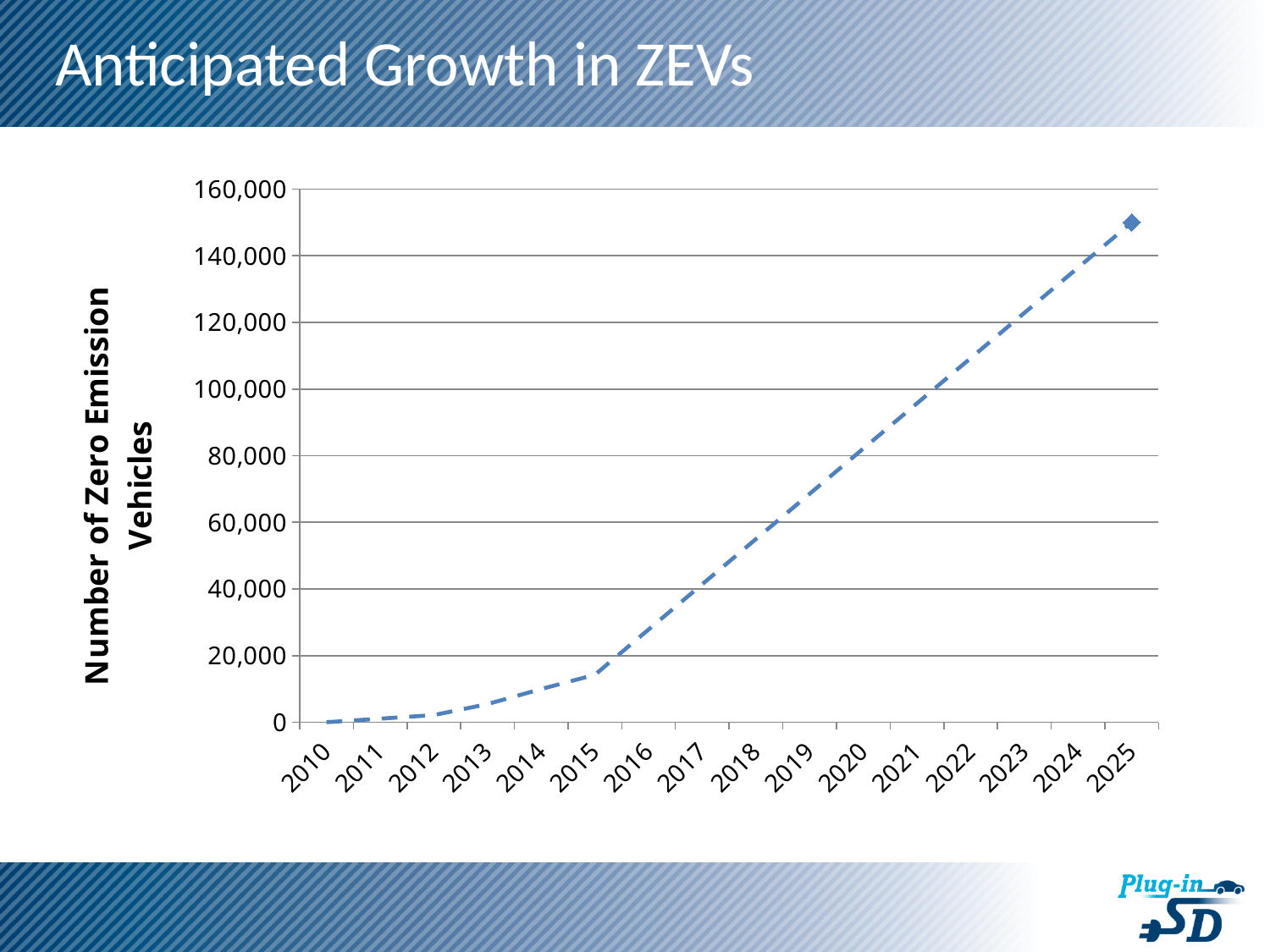
Is the value for 2015 greater or less than 20,000? less Which year has the highest number of zero emission vehicles? 2025 Do the values rise or fall from 2010 to 2025? rise Is the value for 2018 greater or less than 40,000? greater How many years are plotted along the x axis? 16 What is the title of the vertical axis? Number of Zero Emission Vehicles Which year has the larger value, 2016 or 2023? 2023 Is the value for 2025 greater or less than 140,000? greater Which year has the lowest number of zero emission vehicles? 2010 What kind of chart is shown on the slide? line chart